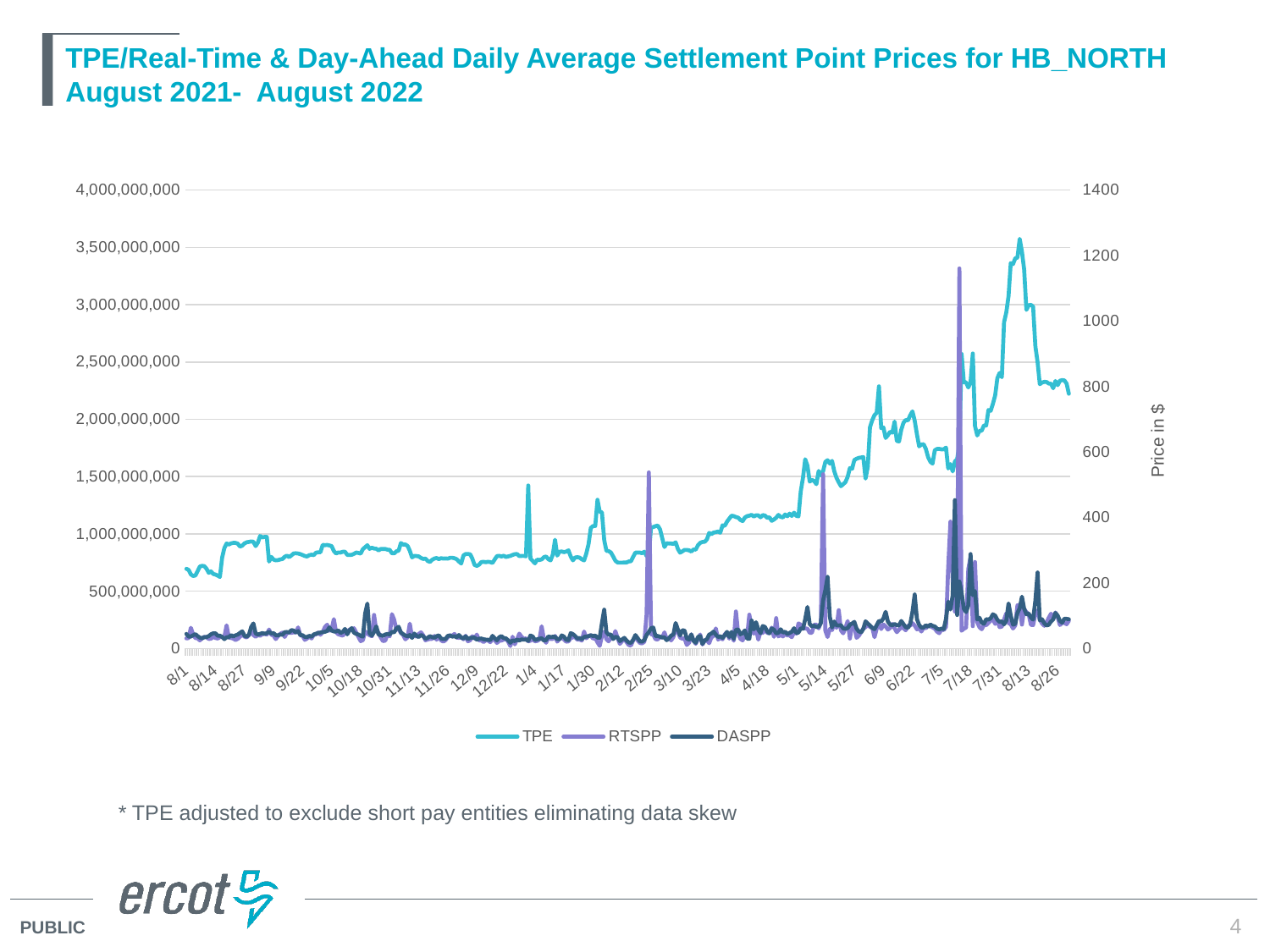
Is the RTSPP spike around 2/25 greater or less than 400 on the right-hand price axis? greater Around which date does the RTSPP series reach its highest peak? 7/18 What is the highest tick value shown on the left-hand vertical axis? 4,000,000,000 Does the TPE series generally rise or fall from 8/1 (August 2021) to 8/26 (August 2022)? Rise Is the highest TPE value, reached around 8/13 near the end of the chart, greater or less than 3,000,000,000? greater What kind of chart is shown on the slide? Line chart What is the title of the right-hand vertical axis? Price in $ How many series does the legend list? 3 Which series reaches the highest point on the right-hand price axis, RTSPP or DASPP? RTSPP Is the TPE value on 8/1 at the start of the chart greater or less than 1,000,000,000? less What are the three series named in the legend? TPE, RTSPP, DASPP